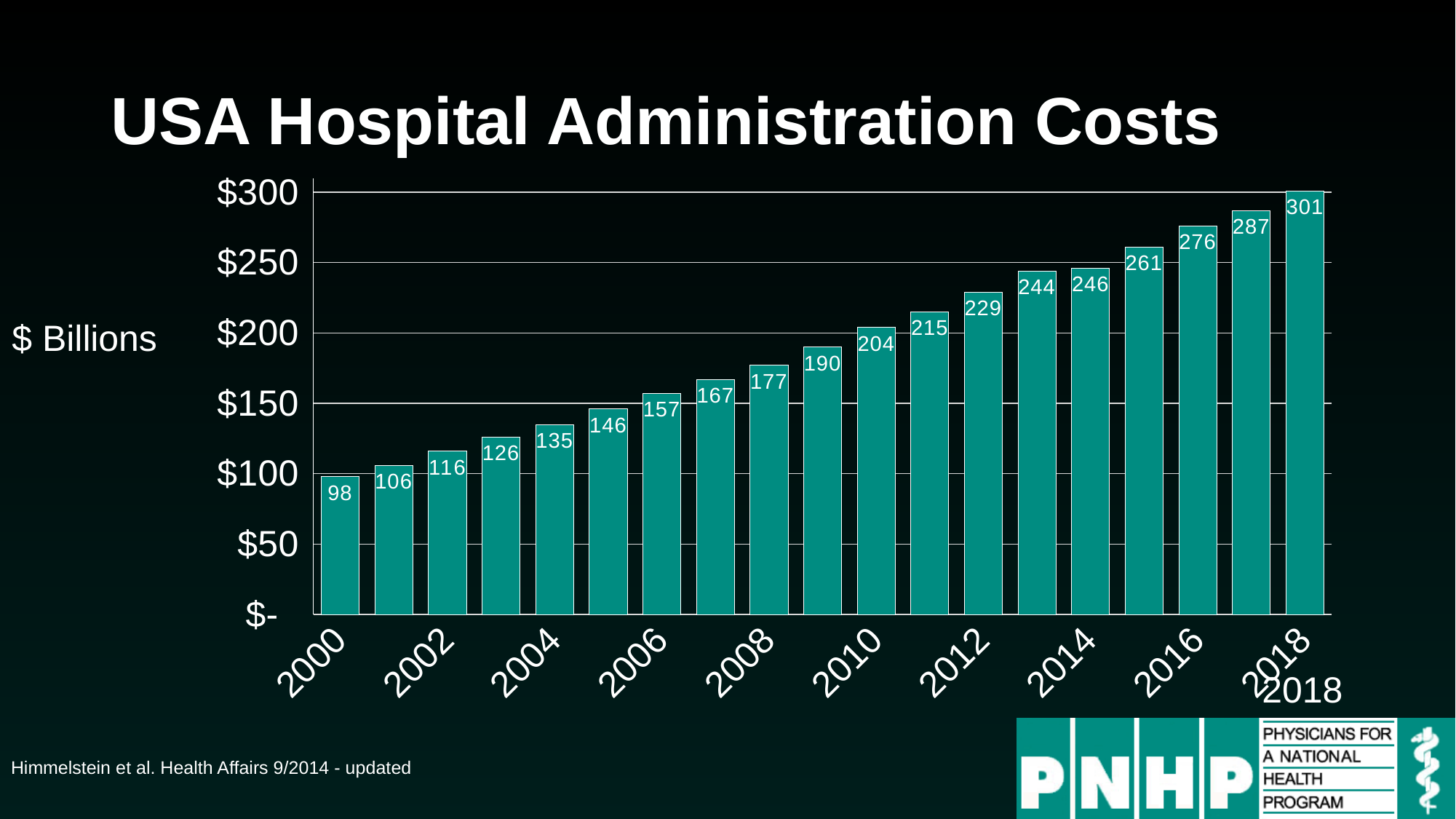
What is the value for 2006? 157 What is the value for 2018? 301 Which year has the lowest value? 2000 What kind of chart is shown? bar chart What is the value for 2010? 204 What is the difference between the values for 2018 and 2000? 203 How many bars are plotted in the chart? 19 Which is larger, the value for 2012 or the value for 2008? 2012 Is the value for 2014 greater or less than $200? greater Do the values rise or fall from 2000 to 2018? rise What is the value for 2000? 98 Which year has the highest value? 2018